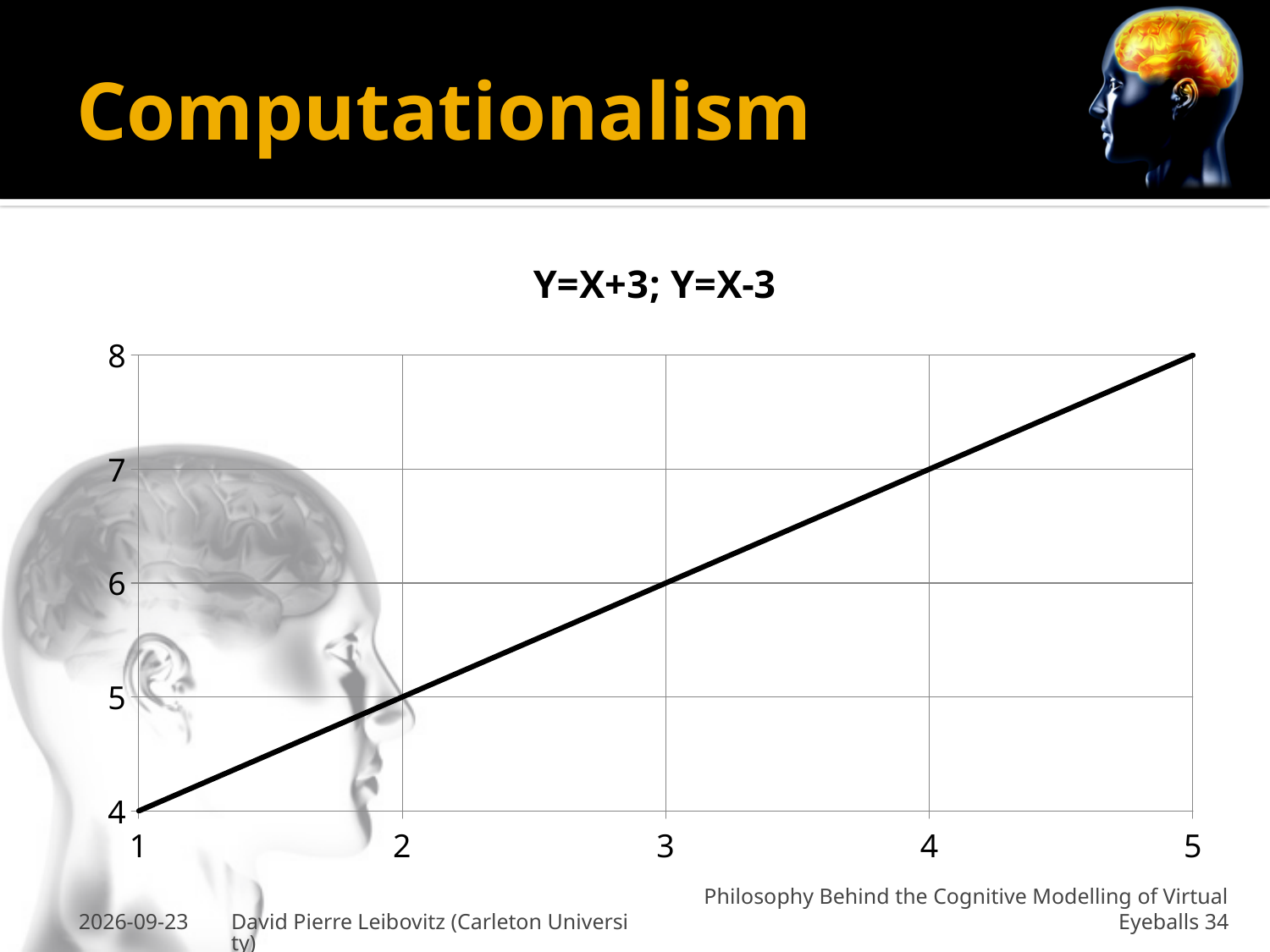
What is the y value of the plotted line at x = 3? 6 At which x value does the line reach its highest y value? 5 Is the y value at x = 2 greater or less than 6? less What kind of chart is shown on the slide? line chart Do the values of the line rise or fall as x increases from 1 to 5? rise At which x value does the line have its lowest y value? 1 What is the difference between the y value at x = 5 and the y value at x = 1? 4 Which has the larger y value: x = 4 or x = 2? x = 4 What is the y value of the plotted line at x = 1? 4 What is the title of the chart? Y=X+3; Y=X-3 How many x-axis tick values are labelled on the chart? 5 What is the y value of the plotted line at x = 5? 8